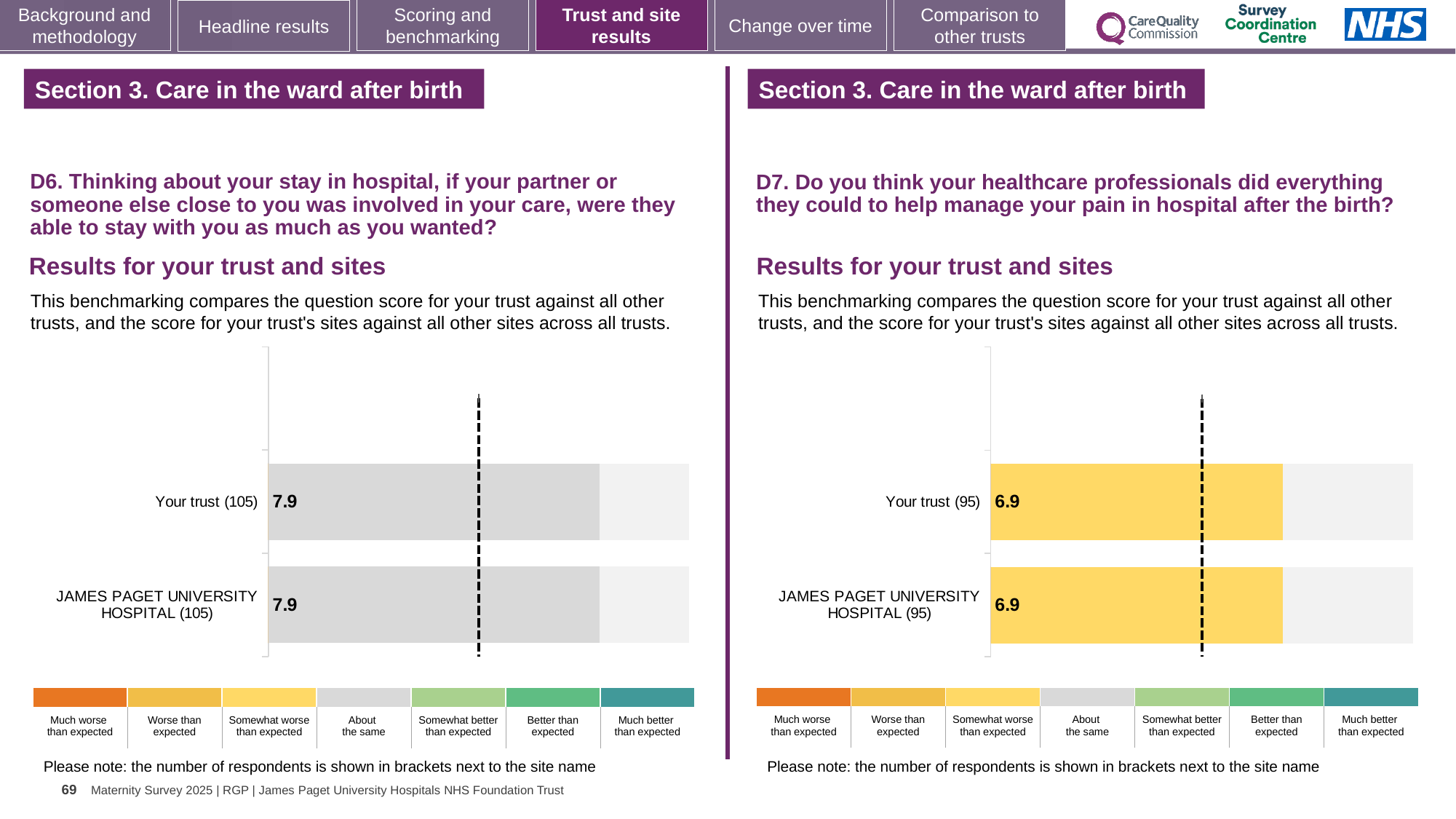
In the D7 chart on the right, which benchmark category does the colour of the Your trust bar correspond to in the key? Somewhat worse than expected In the D7 chart on the right, what is the score for JAMES PAGET UNIVERSITY HOSPITAL? 6.9 In the D6 chart on the left, what is the score for JAMES PAGET UNIVERSITY HOSPITAL? 7.9 How many bars are plotted in the D7 chart on the right? 2 In the D7 chart on the right, what is the difference between the score for Your trust and the score for JAMES PAGET UNIVERSITY HOSPITAL? 0 In the D7 chart on the right, how many respondents are shown in brackets for JAMES PAGET UNIVERSITY HOSPITAL? 95 In the D6 chart on the left, how many respondents are shown in brackets for Your trust? 105 What kind of chart is used for the D6 results on the left? Bar chart In the D6 chart on the left, what is the difference between the score for Your trust and the score for JAMES PAGET UNIVERSITY HOSPITAL? 0 In the D6 chart on the left, what is the score for Your trust? 7.9 How many bars are plotted in the D6 chart on the left? 2 In the D7 chart on the right, what is the score for Your trust? 6.9